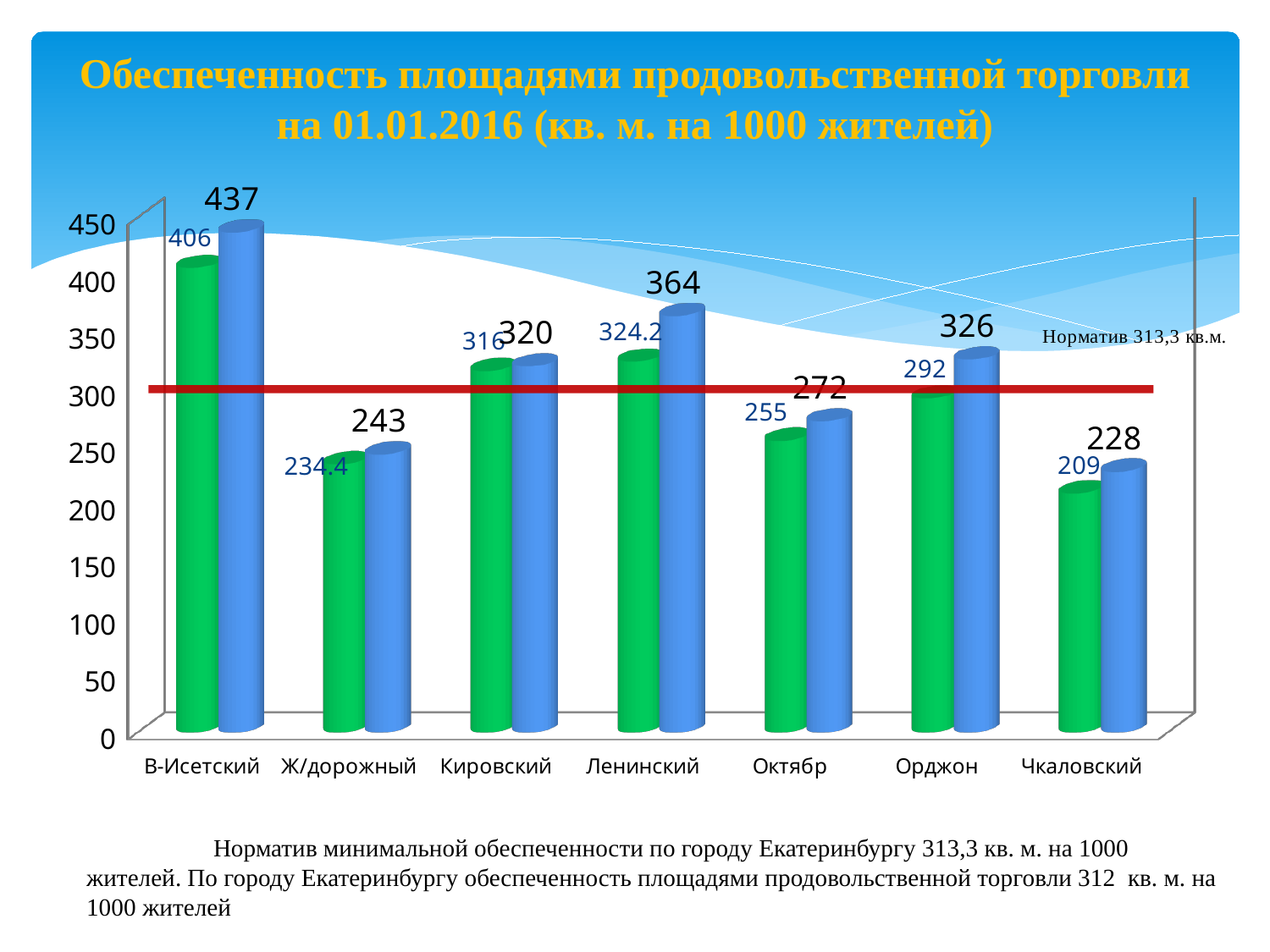
Which district has the highest blue bar? В-Исетский Which district has the lowest green bar? Чкаловский What is the difference between the blue and green bars for В-Исетский? 31 What is the difference between the blue and green bars for Орджон? 34 Which is larger: the green bar for Кировский or the green bar for Ленинский? Ленинский Is the green bar for Октябр greater or less than 300? less How many districts are shown on the x axis? 7 What is the value of the green bar for В-Исетский? 406 What is the value of the blue bar for Ленинский? 364 What is the value of the green bar for Ж/дорожный? 234.4 What kind of chart is shown on the slide? bar chart What value does the red horizontal line (Норматив) represent? 313,3 кв.м.